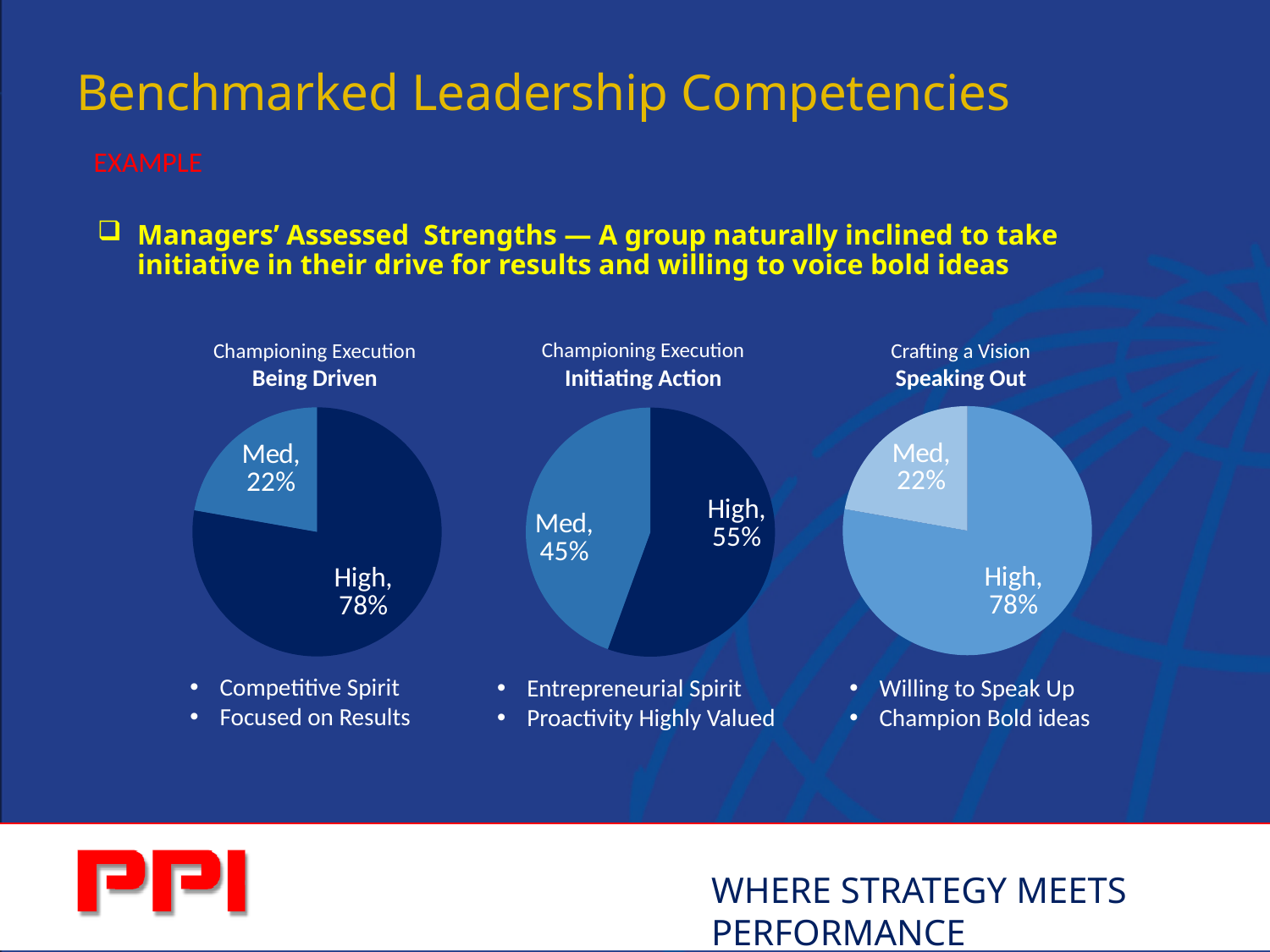
In the Being Driven pie chart, what is the difference between the High and Med percentages? 56% In the Being Driven pie chart, what percentage is labelled Med? 22% How many pie charts are shown on the slide? 3 In the Speaking Out pie chart, what percentage is labelled Med? 22% In the Being Driven pie chart, what percentage is labelled High? 78% In the Initiating Action pie chart, what percentage is labelled High? 55% Which chart has the larger High percentage, Initiating Action or Speaking Out? Speaking Out What type of chart is used for Being Driven? Pie chart In the Speaking Out pie chart, which slice is the largest? High In the Initiating Action pie chart, which slice is the smallest? Med In the Initiating Action pie chart, what percentage is labelled Med? 45% In the Initiating Action pie chart, what is the difference between the High and Med percentages? 10%